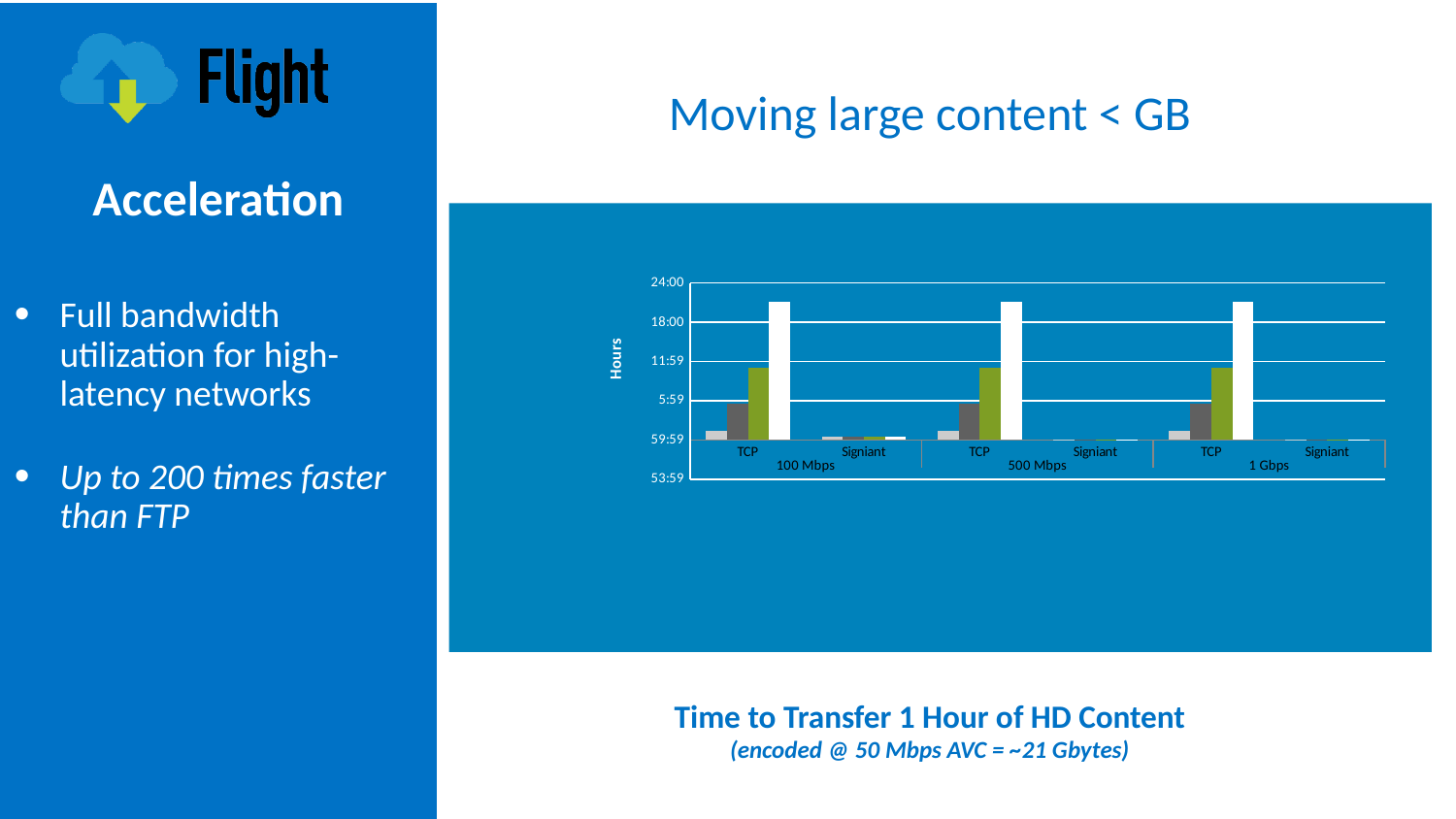
In the 1 Gbps group, which category has the taller bars, TCP or Signiant? TCP Is the tallest bar for TCP in the 500 Mbps group greater or less than 24:00 on the Hours axis? less What caption is printed below the chart describing what it measures? Time to Transfer 1 Hour of HD Content Is the tallest bar for TCP in the 1 Gbps group greater or less than 18:00 on the Hours axis? greater What is the title of the vertical axis of the chart? Hours How many bars are plotted for the TCP category in the 100 Mbps group? 4 In the 100 Mbps group, which category has the taller bars, TCP or Signiant? TCP In the 500 Mbps group, which category shows the shorter transfer times? Signiant Is the tallest bar for TCP in the 100 Mbps group greater or less than 18:00 on the Hours axis? greater How many category labels (TCP and Signiant entries) appear along the x axis of the chart? 6 What kind of chart is shown on the slide? bar chart How many network speed groups are shown along the x axis of the chart? 3